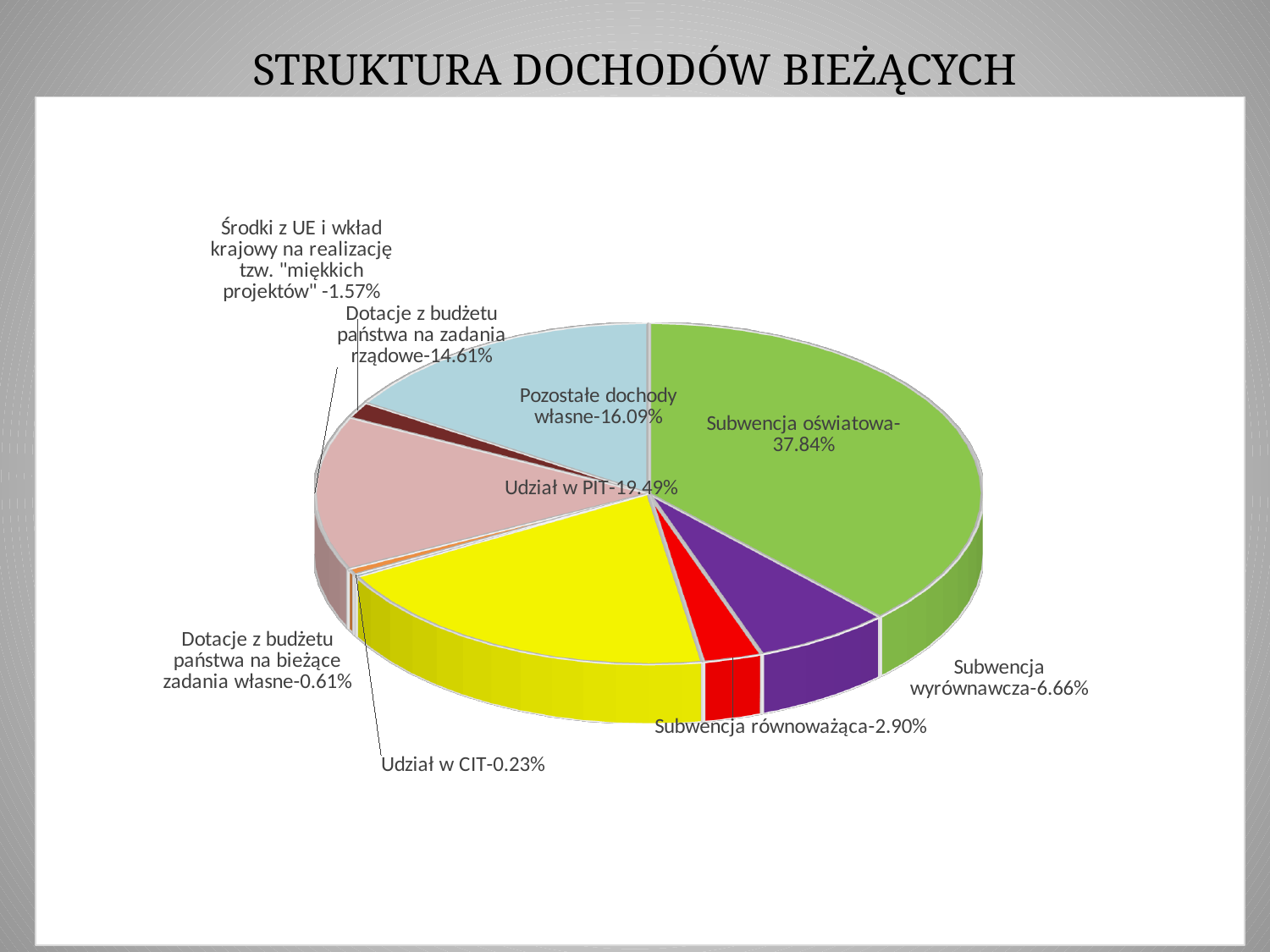
How many slices does the pie chart have? 9 What is the value shown for Pozostałe dochody własne? 16.09% What is the value shown for Dotacje z budżetu państwa na zadania rządowe? 14.61% What kind of chart is shown on the slide? Pie chart What is the value shown for Udział w PIT? 19.49% What share does Subwencja oświatowa have in the pie chart? 37.84% What is the difference between the shares of Subwencja oświatowa and Udział w PIT? 18.35% What is the value shown for Udział w CIT? 0.23% Which category has the smallest share of the pie? Udział w CIT Which is larger: Subwencja wyrównawcza or Subwencja równoważąca? Subwencja wyrównawcza What is the title of the slide's chart? STRUKTURA DOCHODÓW BIEŻĄCYCH Which category has the largest share of the pie? Subwencja oświatowa